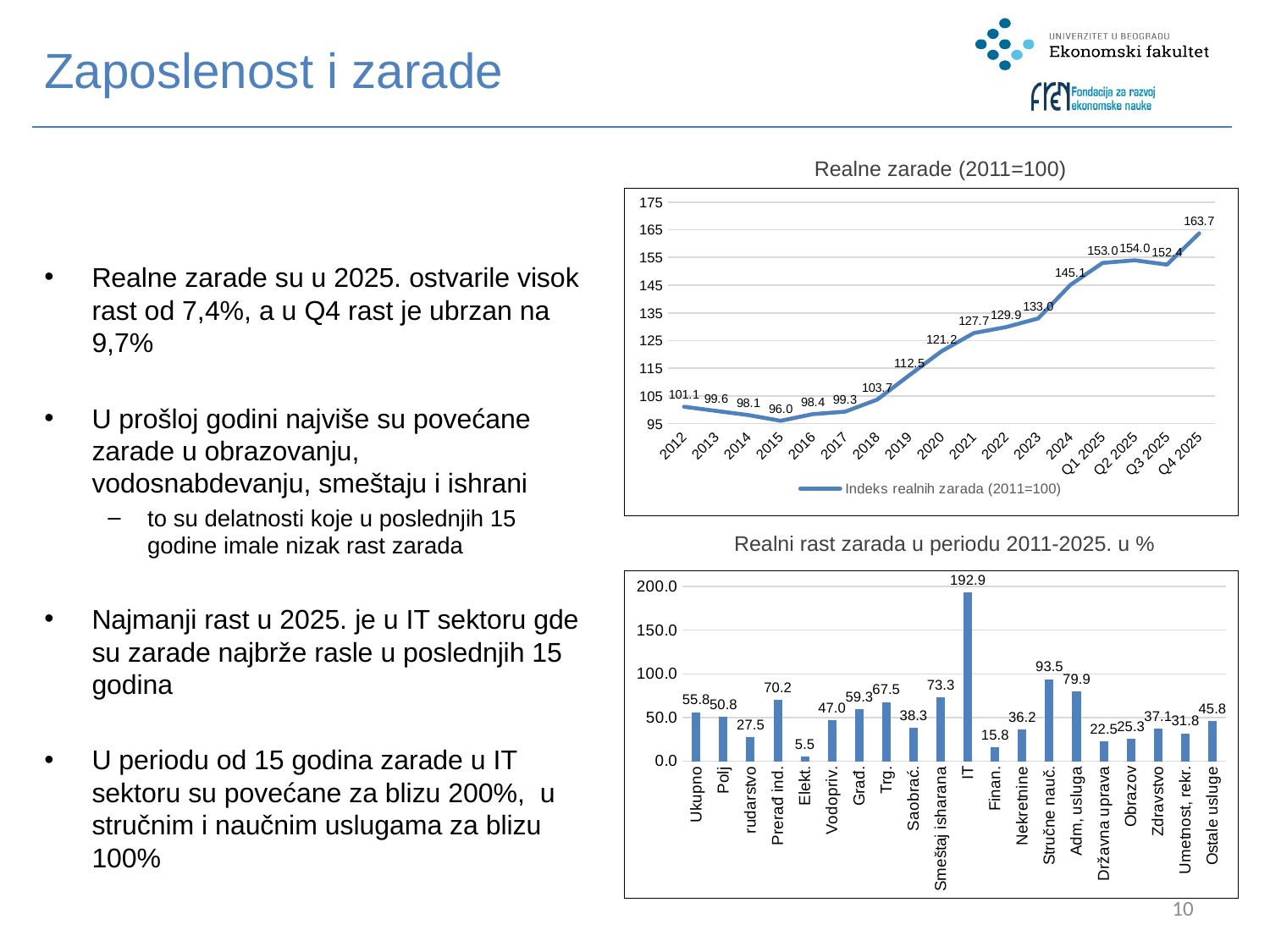
In the chart 'Realne zarade (2011=100)', what is the index value for 2019? 112.5 In the chart 'Realni rast zarada u periodu 2011-2025. u %', what is the value for IT? 192.9 What is the legend entry in the chart 'Realne zarade (2011=100)'? Indeks realnih zarada (2011=100) In the chart 'Realne zarade (2011=100)', how many data points are plotted? 17 In the chart 'Realne zarade (2011=100)', what is the index value for Q4 2025? 163.7 In the chart 'Realne zarade (2011=100)', what is the difference between the values for 2024 and 2023? 12.1 In the chart 'Realni rast zarada u periodu 2011-2025. u %', which category has the lowest value? Elekt. What type of chart is 'Realne zarade (2011=100)'? Line chart In the chart 'Realne zarade (2011=100)', do the values generally rise or fall from 2018 to Q4 2025? Rise In the chart 'Realni rast zarada u periodu 2011-2025. u %', which is larger: Stručne nauč. or Adm. usluga? Stručne nauč. In the chart 'Realne zarade (2011=100)', which year has the lowest index value? 2015 In the chart 'Realni rast zarada u periodu 2011-2025. u %', how many categories are shown? 20